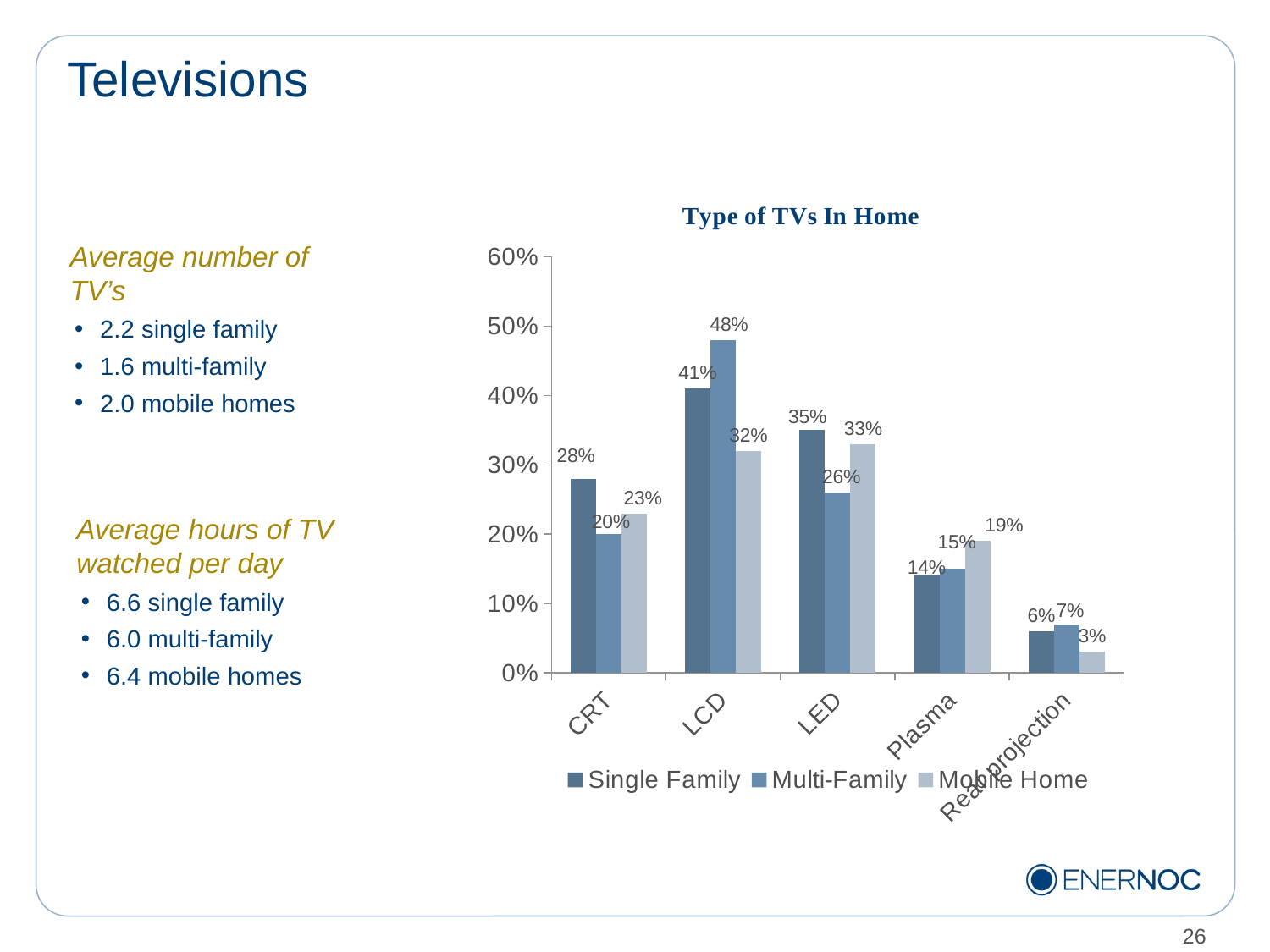
Is the Single Family value for LED greater or less than 30%? greater What is the value for Multi-Family in the LED category? 26% What is the value for Single Family in the LCD category? 41% How many TV type categories are shown on the x axis? 5 What is the value for Mobile Home in the Plasma category? 19% Which category has the highest Multi-Family value? LCD What is the difference between the Multi-Family and Single Family values for LCD? 7% What type of chart is shown on the slide? bar chart Which category has the lowest Mobile Home value? Rear projection What is the title of the chart? Type of TVs In Home Which is larger in the CRT category: Single Family or Mobile Home? Single Family How many series does the legend list? 3